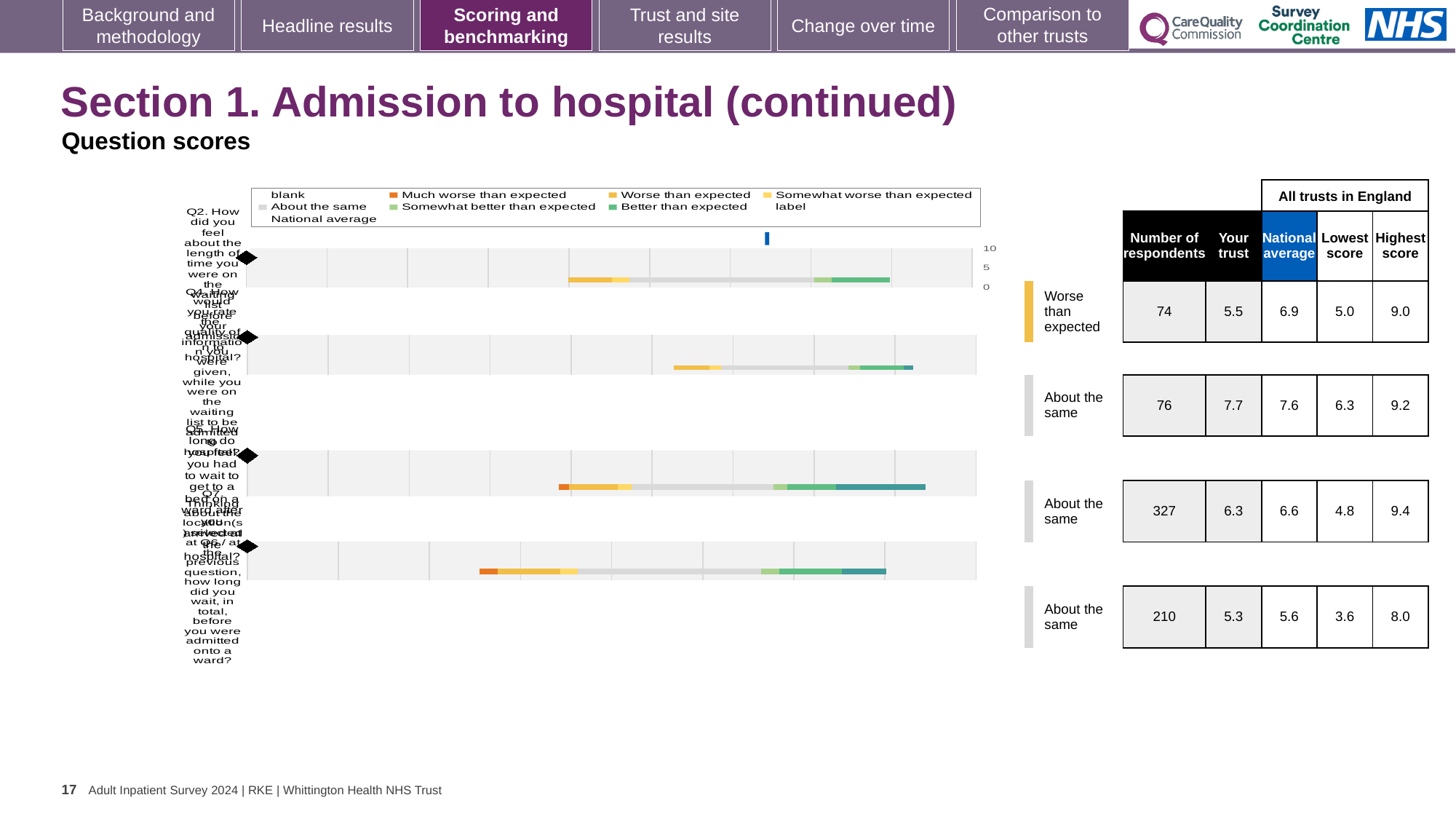
How many question rows are plotted in the chart? 4 What is the 'Your trust' score for the second question row? 7.7 For the second question row, which is larger: the 'Your trust' score or the national average? Your trust (7.7) What kind of chart is used to show the question scores? Bar chart What is the highest score for the fourth question row (210 respondents)? 8.0 How many respondents are shown for the first question row in the table? 74 Which question row has the lowest 'Lowest score' value? The fourth row (3.6) Which question row has the largest number of respondents? The third row (327) For the first question row, how much higher is the national average than the 'Your trust' score? 1.4 Which column header in the table is highlighted in blue? National average What benchmark category is assigned to the first question row? Worse than expected What is the national average for the third question row (327 respondents)? 6.6